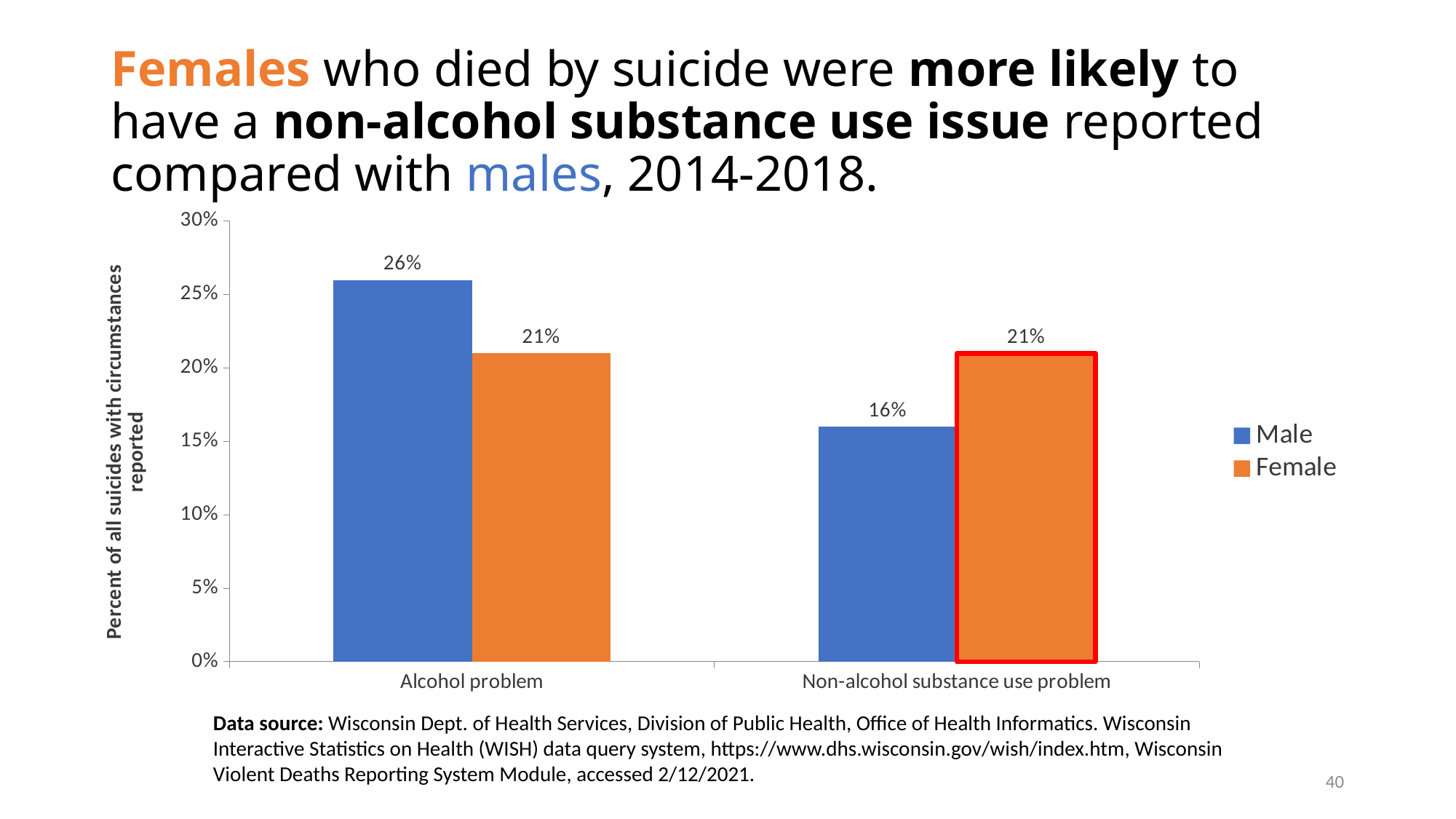
What is the difference between the Female and Male values for Non-alcohol substance use problem? 5% What is the value for Male in the Non-alcohol substance use problem category? 16% For Non-alcohol substance use problem, which is larger, the Male or the Female value? Female What kind of chart is shown on the slide? Bar chart What is the difference between the Male and Female values for Alcohol problem? 5% Which bar has the highest value on the chart? Male, Alcohol problem What is the value for Male in the Alcohol problem category? 26% How many categories are shown on the x axis? 2 How many series does the legend list? 2 Which bar has the lowest value on the chart? Male, Non-alcohol substance use problem What is the value for Female in the Non-alcohol substance use problem category? 21% What is the value for Female in the Alcohol problem category? 21%